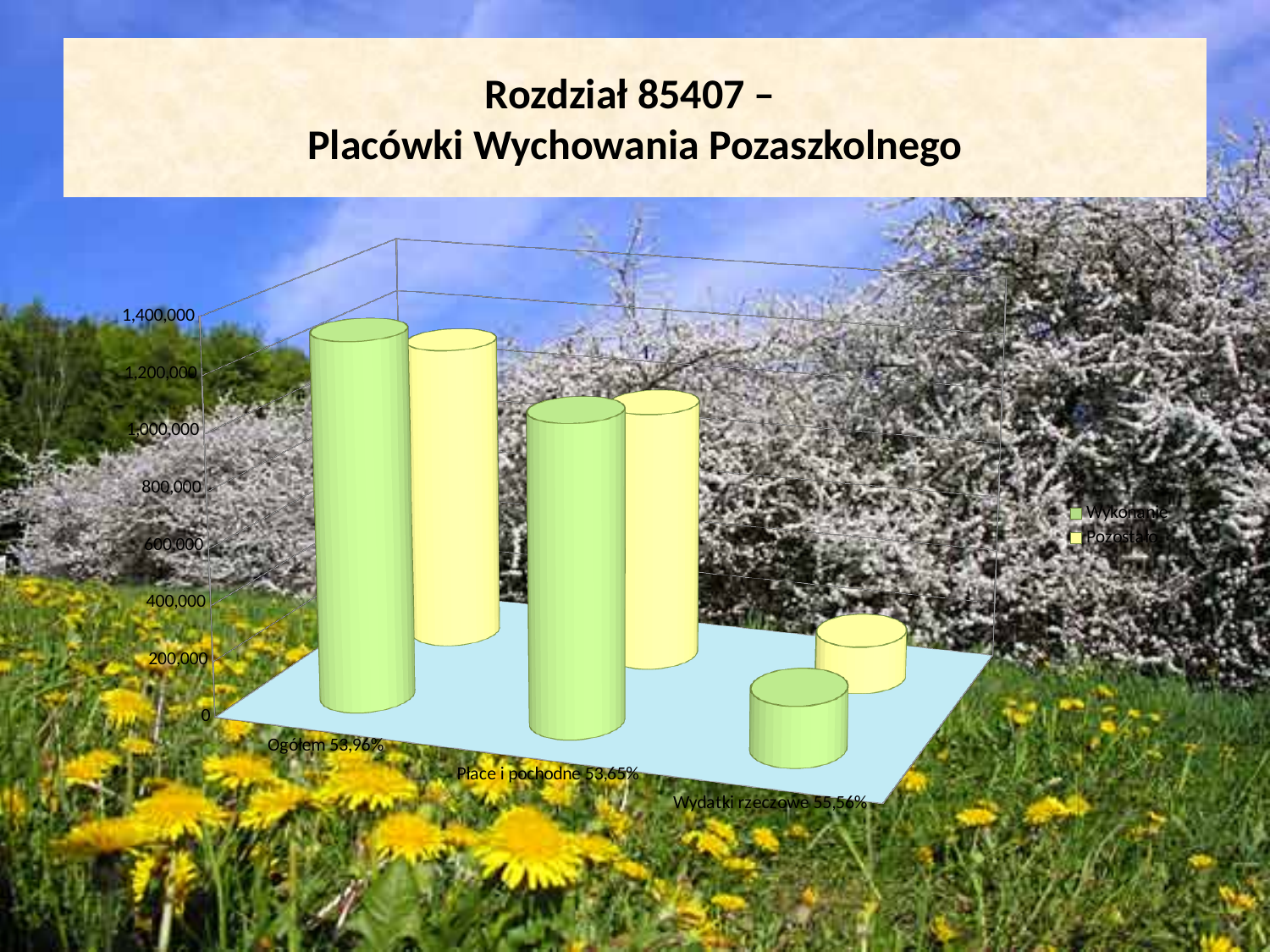
What percentage is printed in the x-axis label for Wydatki rzeczowe? 55,56% Which category has the lowest Pozostało value? Wydatki rzeczowe 55,56% Is the Wykonanie value for Ogółem greater or less than 1,000,000? greater How many categories are shown on the x axis? 3 What are the two legend entries of the chart? Wykonanie, Pozostało How many series does the legend list? 2 Which is larger: the Wykonanie value for Płace i pochodne or the Wykonanie value for Wydatki rzeczowe? Płace i pochodne Is the Pozostało value for Płace i pochodne greater or less than 600,000? greater Which category has the highest Wykonanie value? Ogółem 53,96% What kind of chart is shown on the slide? bar chart Is the Wykonanie value for Wydatki rzeczowe greater or less than 400,000? less Do the Wykonanie values rise or fall from Ogółem to Wydatki rzeczowe along the x axis? fall